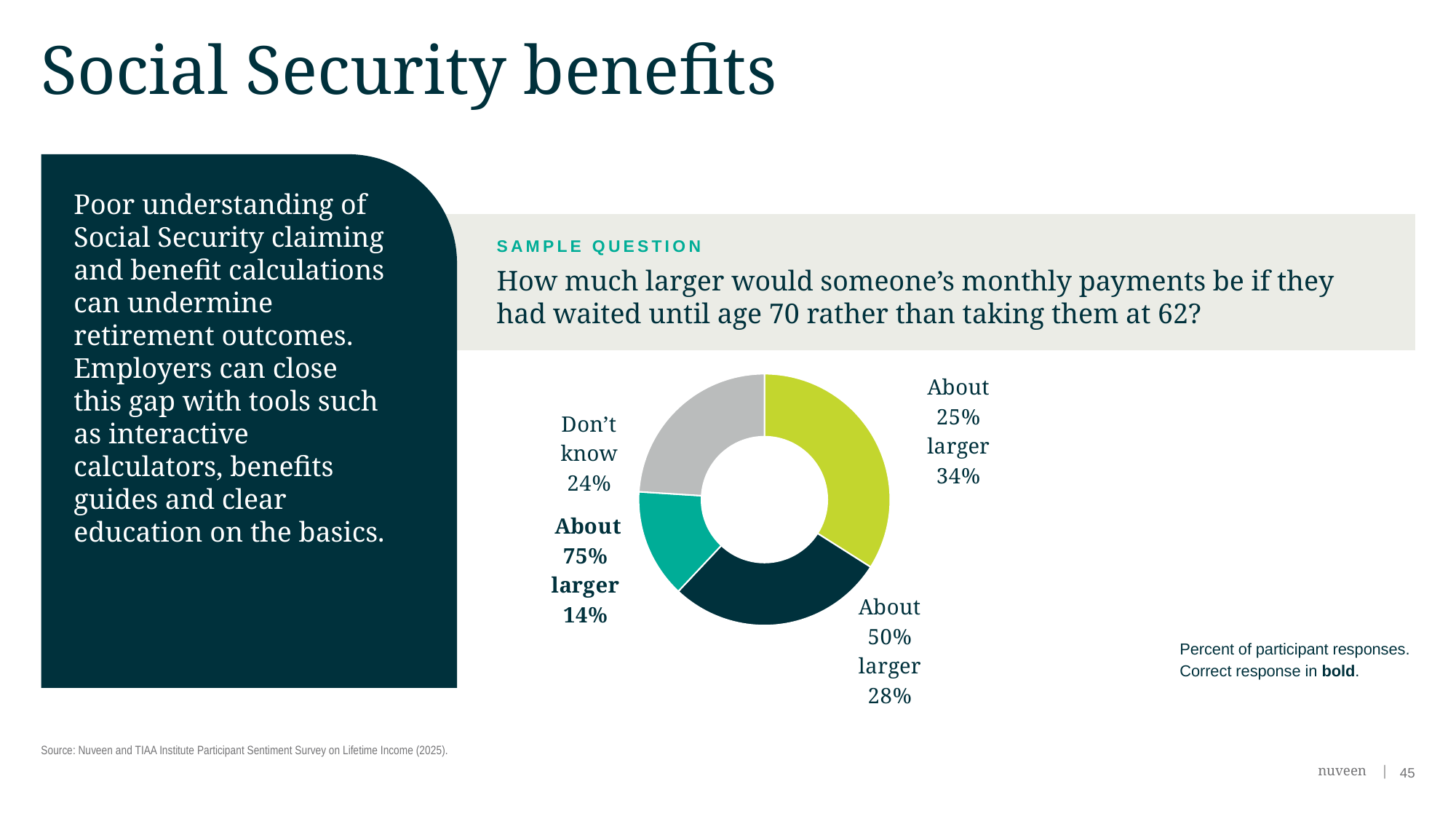
Which response had a larger share: "Don't know" or "About 50% larger"? About 50% larger Which response is marked as the correct answer (shown in bold)? About 75% larger What percentage of participants answered "Don't know"? 24% Which response received the largest share of participants? About 25% larger How many response categories are shown in the chart? 4 What percentage of participants answered "About 75% larger"? 14% What percentage of participants answered "About 25% larger"? 34% What is the combined share of participants who answered "About 25% larger" or "About 50% larger"? 62% What percentage of participants answered "About 50% larger"? 28% Which response received the smallest share of participants? About 75% larger What kind of chart is used to show the participant responses? Pie chart (donut) What is the difference in percentage points between "About 25% larger" and "About 75% larger"? 20